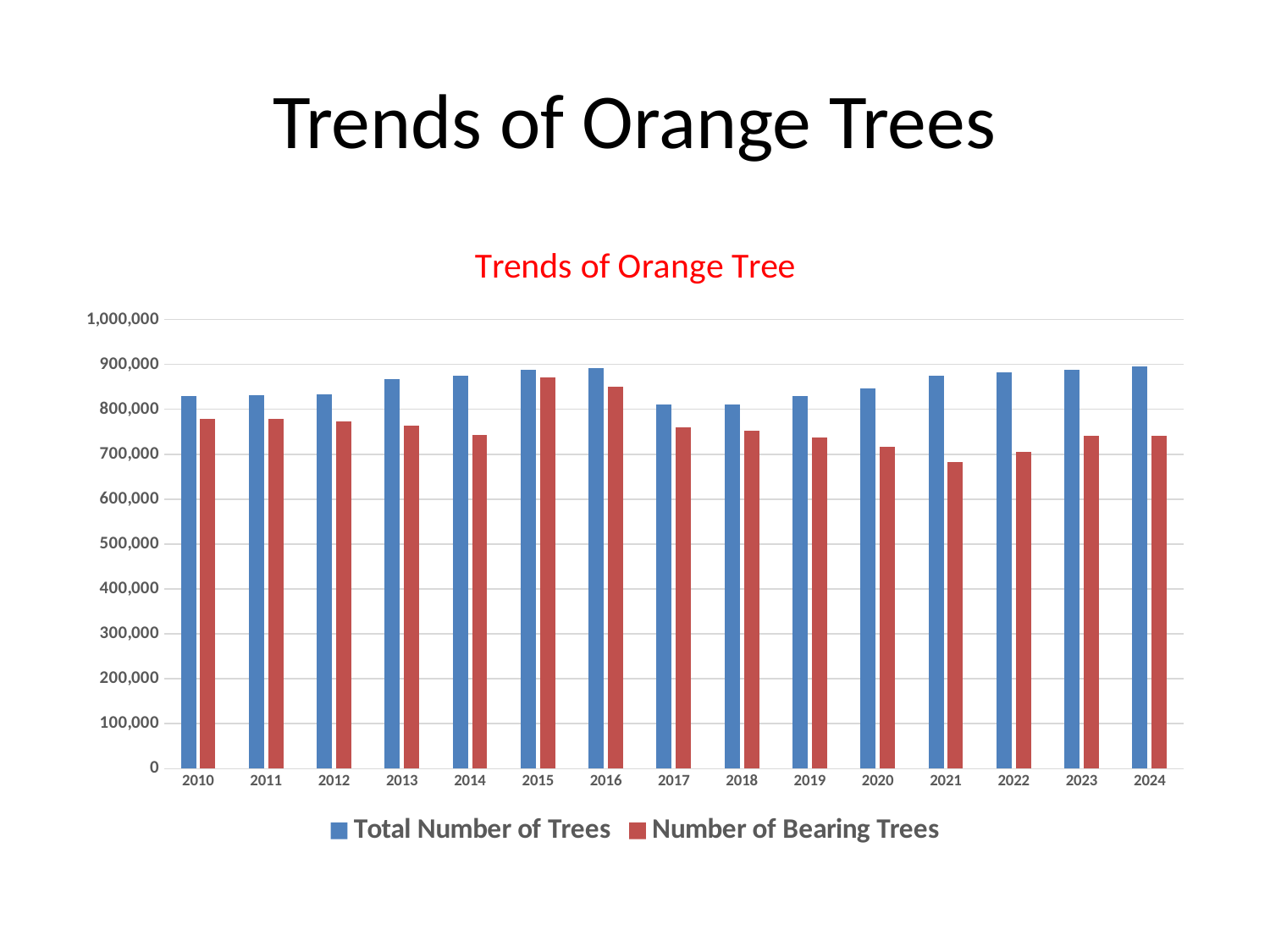
What is the title shown above the chart? Trends of Orange Tree What kind of chart is shown on the slide? bar chart How many years are shown on the x axis? 15 Is the Number of Bearing Trees in 2014 greater or less than 800,000? less Which is larger: the Total Number of Trees in 2016 or in 2017? 2016 Is the Total Number of Trees in 2015 greater or less than 800,000? greater Which is larger: the Number of Bearing Trees in 2015 or in 2021? 2015 Which year has the lowest Number of Bearing Trees? 2021 Which year has the highest Number of Bearing Trees? 2015 Does the Number of Bearing Trees rise or fall from 2016 to 2021? fall Is the Number of Bearing Trees in 2021 greater or less than 700,000? less How many series does the legend list? 2